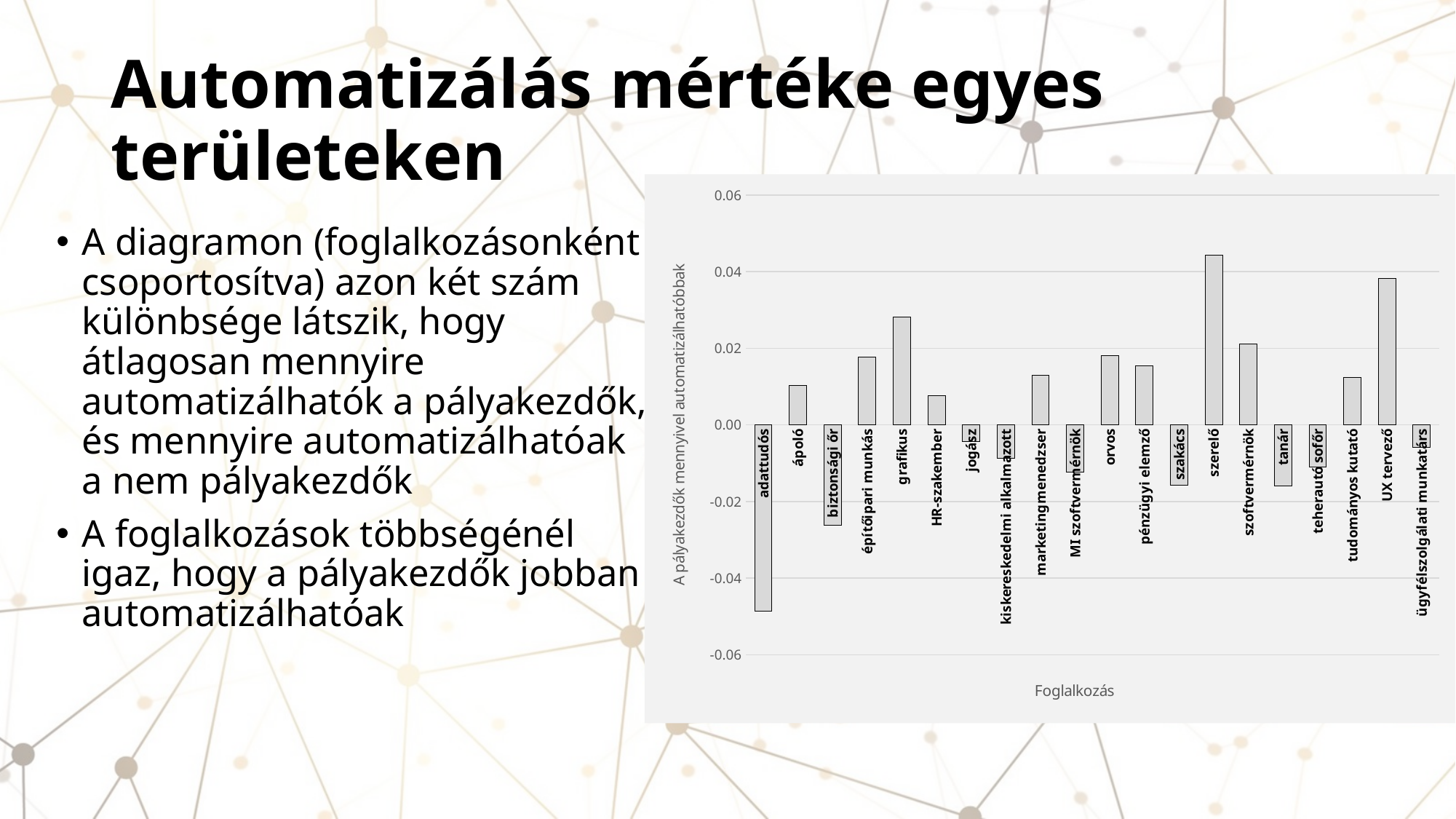
What is the title of the horizontal axis of the chart? Foglalkozás Is the value for biztonsági őr greater or less than -0.02? less What kind of chart is shown on the slide? bar chart Is the value for adattudós greater or less than -0.04? less Which occupation has the highest value on the chart? szerelő Is the value for UX tervező greater or less than 0.02? greater Which has the larger value, szerelő or grafikus? szerelő How many occupations (categories) are plotted on the chart? 20 Which occupation has the lowest value on the chart? adattudós Which has the lower value, adattudós or biztonsági őr? adattudós